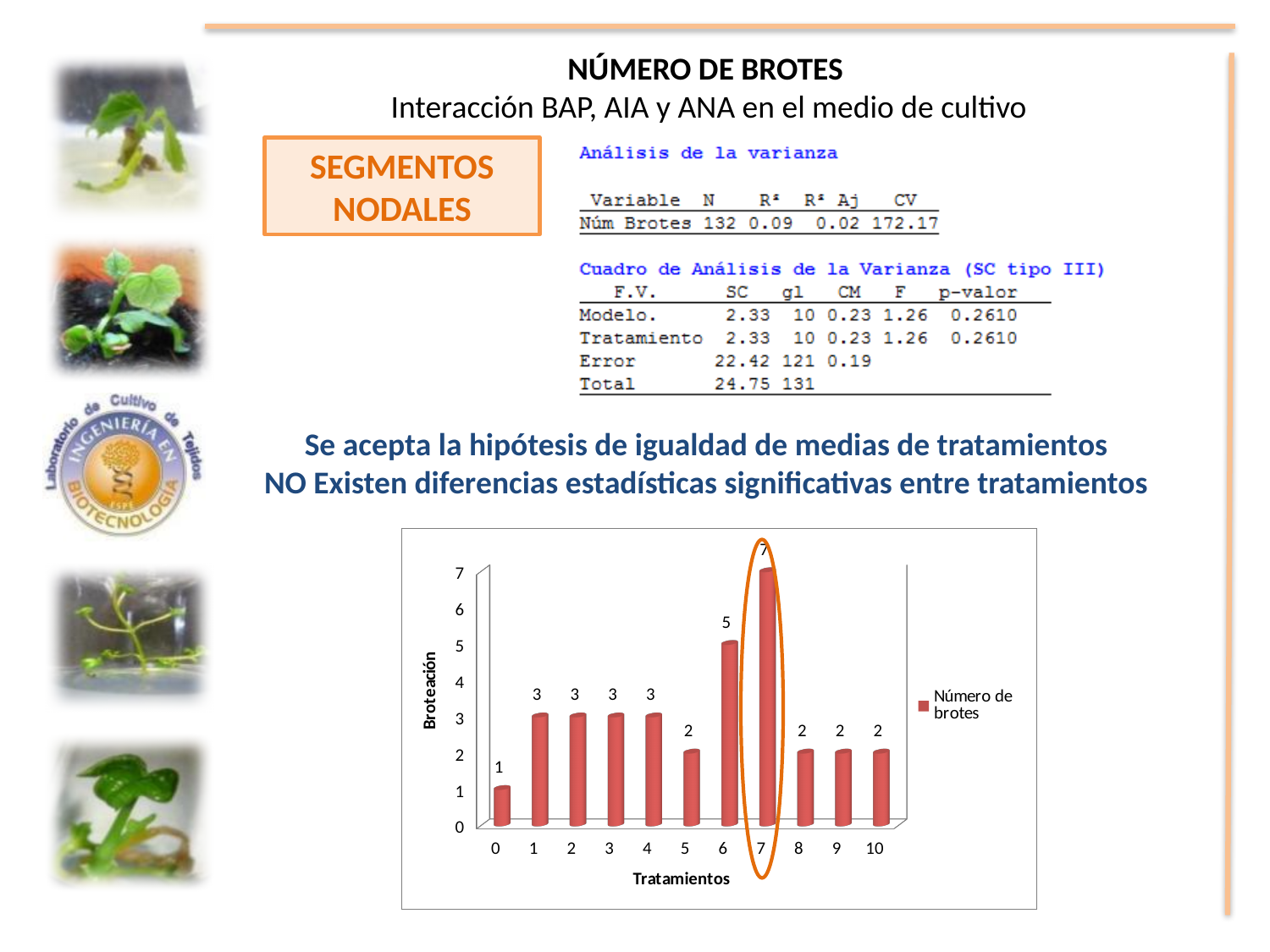
What is the value for treatment 5 in the chart? 2 What is the difference between the values for treatment 7 and treatment 6? 2 What is the value for treatment 0 in the chart? 1 Which treatment has the highest number of brotes? 7 Which treatment has the lowest number of brotes? 0 How many treatments are shown on the x axis of the chart? 11 What is the value for treatment 6 in the chart? 5 What is the label of the y axis of the chart? Broteación What is the value for treatment 7 in the chart? 7 Which is larger, the value for treatment 1 or the value for treatment 8? treatment 1 What kind of chart is shown on the slide? bar chart How many series does the chart legend list? 1